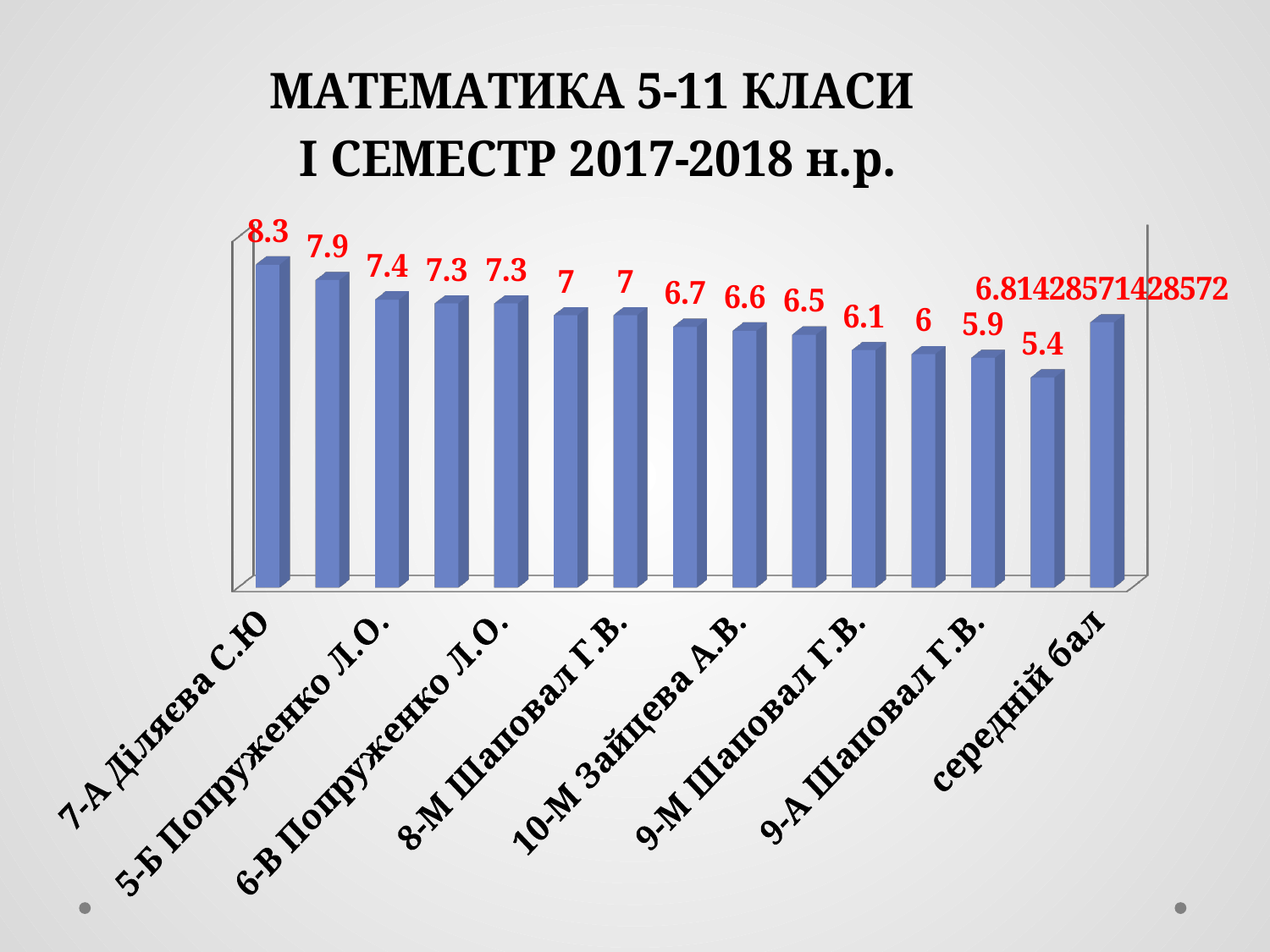
What is the value for 7-А Діляєва С.Ю? 8.3 Which category has the highest value? 7-А Діляєва С.Ю Which is larger, the value for 6-В Попруженко Л.О. or the value for 9-М Шаповал Г.В.? 6-В Попруженко Л.О. What is the value for 10-М Зайцева А.В.? 6.6 What is the value for 5-Б Попруженко Л.О.? 7.4 What is the lowest value shown on the chart? 5.4 What is the difference between the values for 7-А Діляєва С.Ю and 9-А Шаповал Г.В.? 2.4 How many bars are plotted on the chart? 15 What kind of chart is shown on the slide? Bar chart What is the value for 8-М Шаповал Г.В.? 7 What is the value for 9-А Шаповал Г.В.? 5.9 What is the value labelled for середній бал? 6.81428571428572